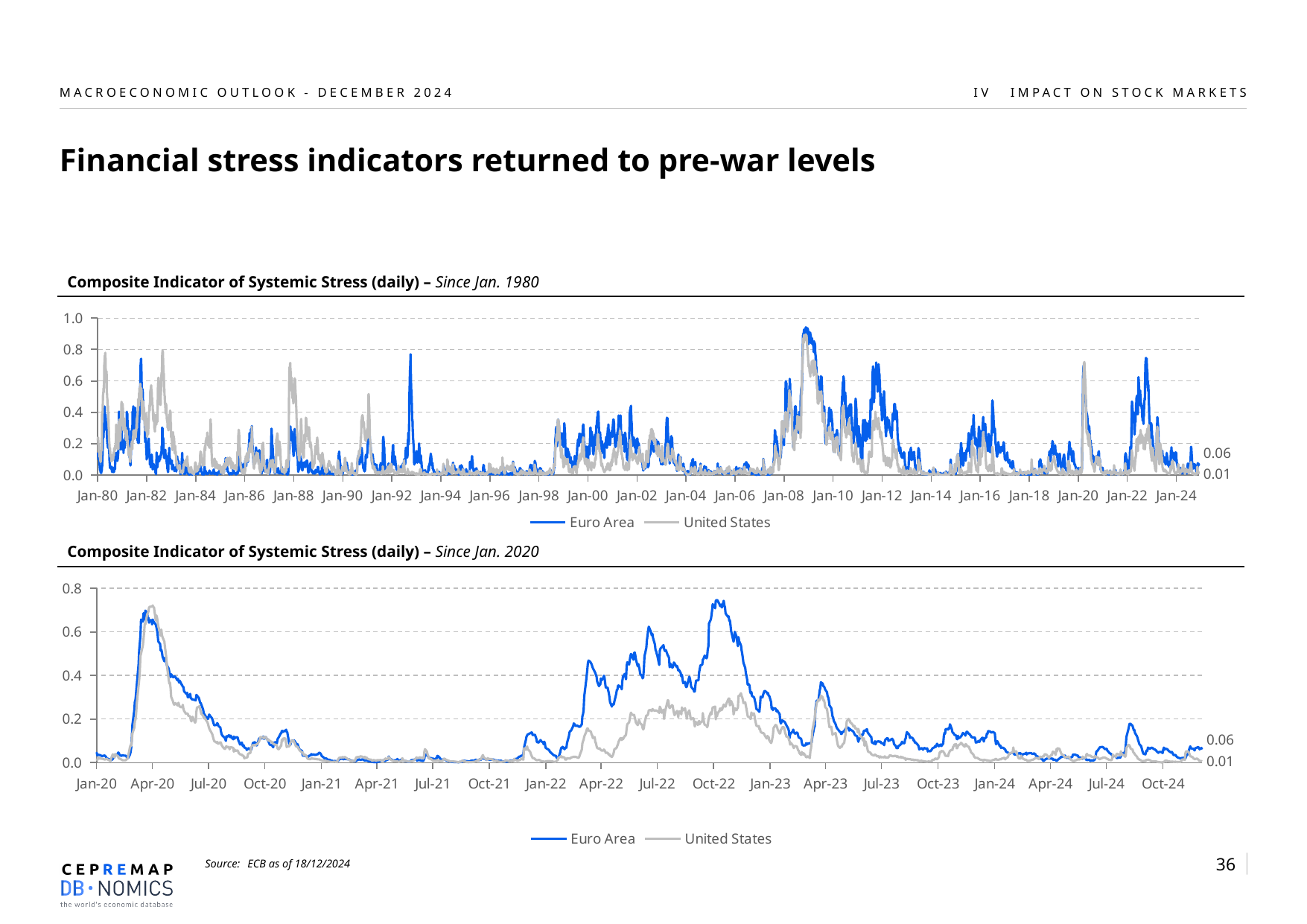
In the top chart, 'Since Jan. 1980', what is the latest value shown for the Euro Area? 0.06 In the top chart, 'Since Jan. 1980', is the Euro Area peak around Jan-09 greater or less than 0.8? greater In the bottom chart, 'Since Jan. 2020', what is the difference between the latest Euro Area value and the latest United States value? 0.05 What kind of chart is the top chart, 'Composite Indicator of Systemic Stress (daily) – Since Jan. 1980'? Line chart What colour is the Euro Area line in the bottom chart, 'Since Jan. 2020'? Blue In the bottom chart, 'Since Jan. 2020', what is the latest value shown for the United States? 0.01 In the bottom chart, 'Since Jan. 2020', is the Euro Area peak around Oct-22 greater or less than 0.6? greater In the bottom chart, 'Since Jan. 2020', which series has the higher latest value, Euro Area or United States? Euro Area In the bottom chart, 'Since Jan. 2020', is the United States value around Oct-22 greater or less than 0.4? less How many series does the legend of the bottom chart, 'Since Jan. 2020', list? 2 Which two series are listed in the legend of the top chart, 'Since Jan. 1980'? Euro Area and United States In the bottom chart, 'Since Jan. 2020', what is the latest value shown for the Euro Area? 0.06